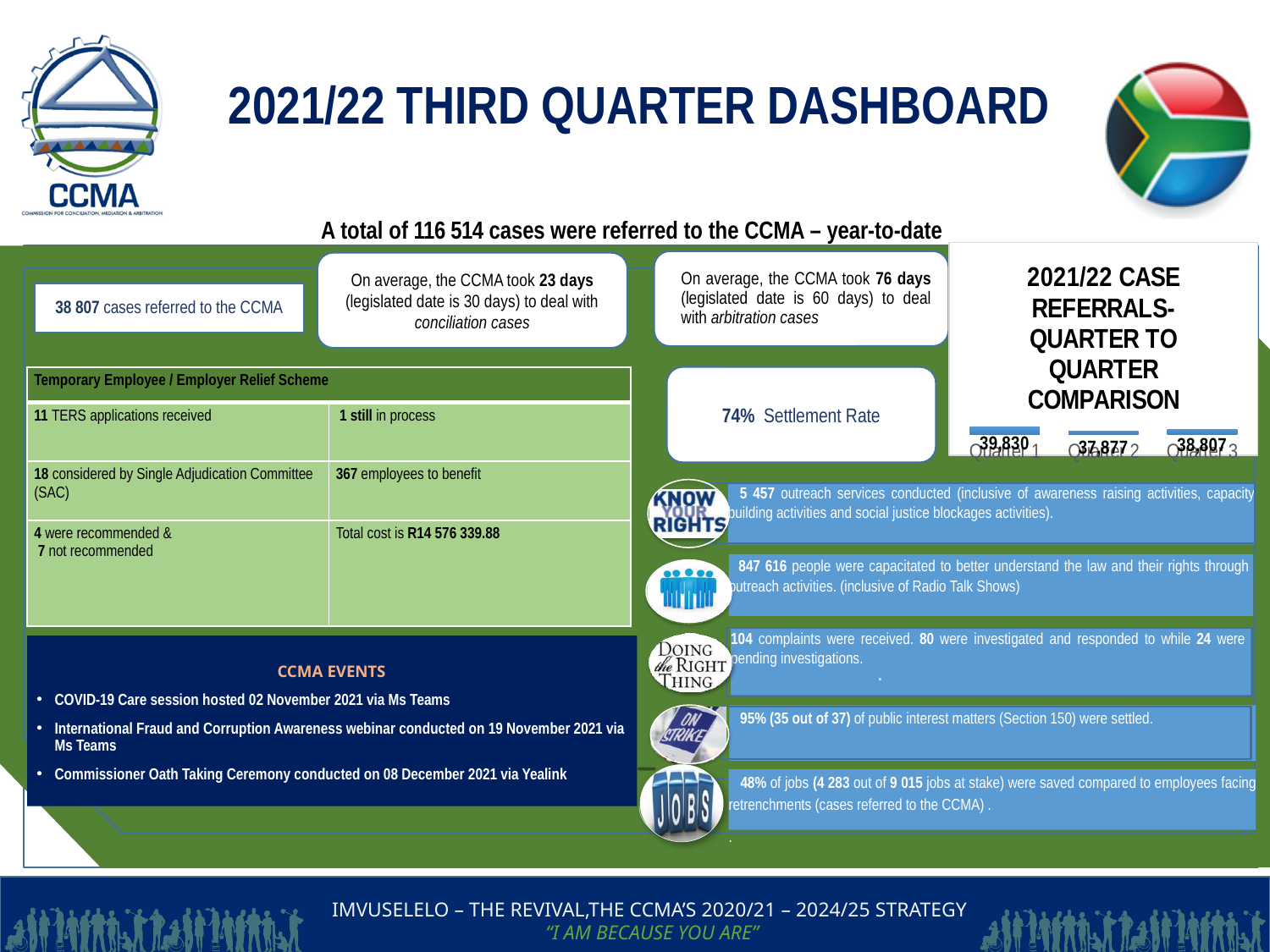
In the 2021/22 Case Referrals chart, which quarter has the highest number of case referrals? Quarter 1 In the 2021/22 Case Referrals chart, which is larger, the value for Quarter 1 or the value for Quarter 3? Quarter 1 In the 2021/22 Case Referrals chart, which quarter has the lowest number of case referrals? Quarter 2 What is the title of the chart on the slide? 2021/22 CASE REFERRALS- QUARTER TO QUARTER COMPARISON What kind of chart is the 2021/22 Case Referrals - Quarter to Quarter Comparison chart? Bar chart In the 2021/22 Case Referrals chart, what is the value for Quarter 3? 38,807 In the 2021/22 Case Referrals chart, what is the value for Quarter 2? 37,877 In the 2021/22 Case Referrals chart, does the value rise or fall from Quarter 1 to Quarter 2? Fall In the 2021/22 Case Referrals chart, what is the value for Quarter 1? 39,830 How many quarters are shown in the 2021/22 Case Referrals chart? 3 In the 2021/22 Case Referrals chart, what is the difference between the Quarter 1 and Quarter 2 values? 1,953 In the 2021/22 Case Referrals chart, what is the difference between the Quarter 3 and Quarter 2 values? 930